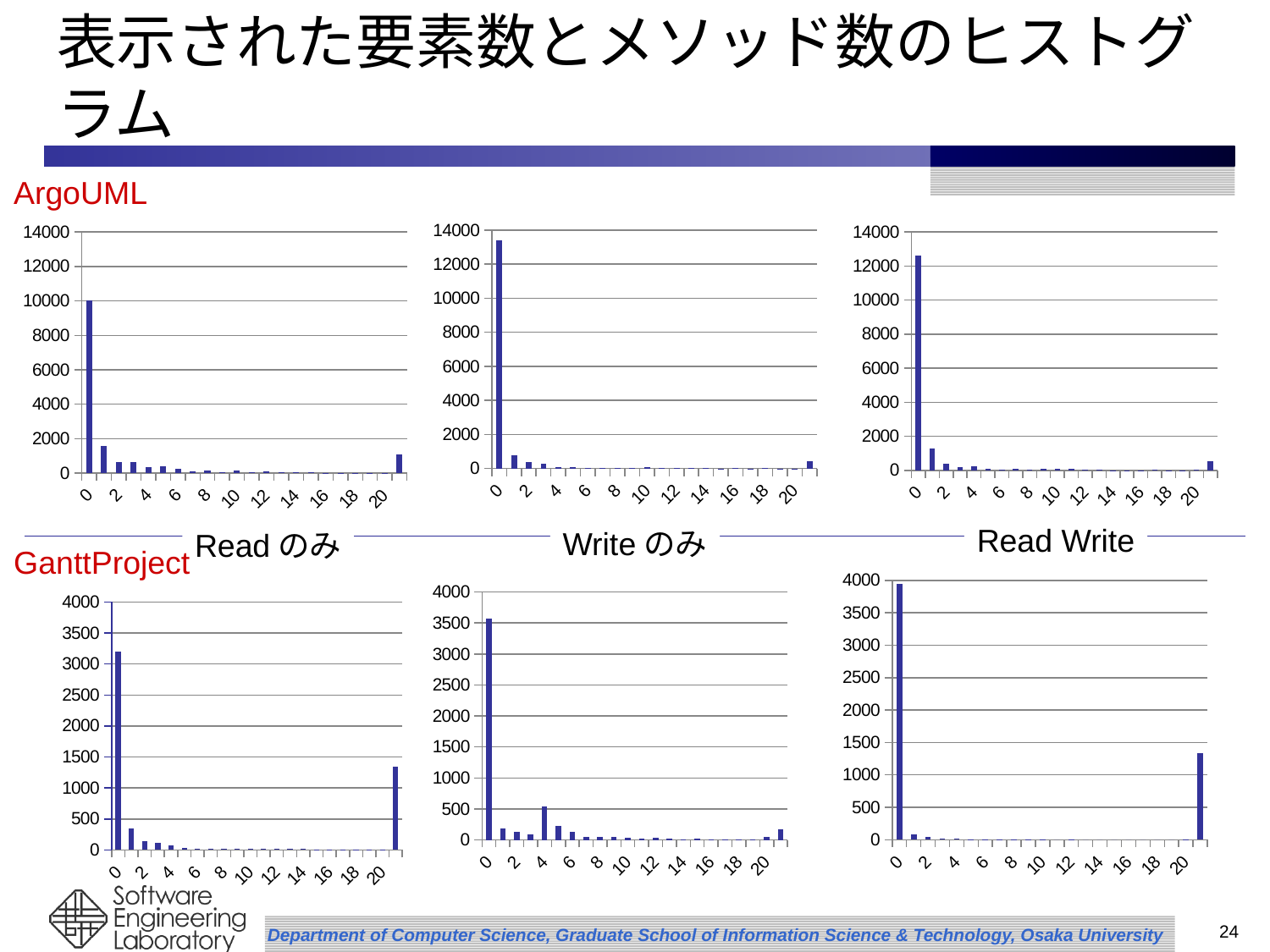
In the ArgoUML Read Write chart, is the value for category 0 greater or less than 12000? greater In the ArgoUML Write のみ chart, is the value for category 0 greater or less than 12000? greater In the GanttProject Read のみ chart, is the value for category 0 greater or less than 3000? greater How many histogram charts are shown on the slide? 6 Which two projects are labelled on the slide for the two rows of histograms? ArgoUML and GanttProject In the GanttProject Read Write chart, which of the two categories 0 or 2 has the larger value? 0 What kind of chart is used for the ArgoUML Read のみ histogram? bar chart In the ArgoUML Read のみ chart, which x-axis category has the highest bar? 0 In the GanttProject Write のみ chart, do the values generally rise or fall as the x-axis goes from 0 to 10? fall